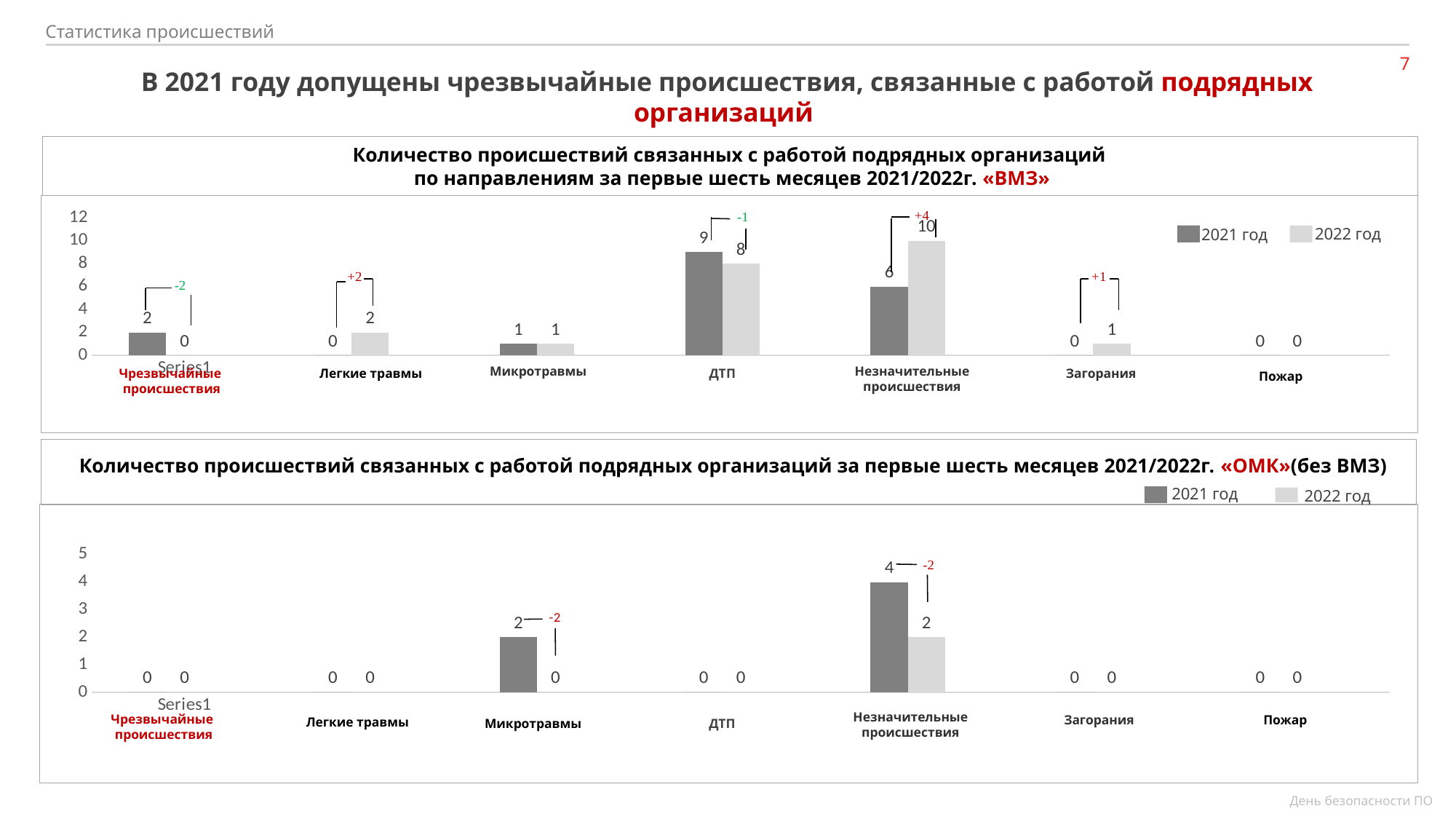
In the top chart («ВМЗ»), how many series does the legend list? 2 What type of chart is the bottom chart («ОМК»)? Bar chart In the bottom chart («ОМК»), what is the value for Микротравмы in 2022 год? 0 In the top chart («ВМЗ»), how many categories are shown on the x axis? 7 In the top chart («ВМЗ»), which is larger for ДТП: the 2021 год value or the 2022 год value? 2021 год In the top chart («ВМЗ»), which category has the highest value for 2022 год? Незначительные происшествия In the bottom chart («ОМК»), what is the difference between the 2021 год and 2022 год values for Незначительные происшествия? 2 In the top chart («ВМЗ»), which category has the highest value for 2021 год? ДТП In the top chart («ВМЗ»), what is the value for Незначительные происшествия in 2022 год? 10 In the top chart («ВМЗ»), what is the difference between the 2022 год and 2021 год values for Незначительные происшествия? 4 In the top chart («ВМЗ»), what is the value for ДТП in 2021 год? 9 In the bottom chart («ОМК»), what is the value for Незначительные происшествия in 2021 год? 4